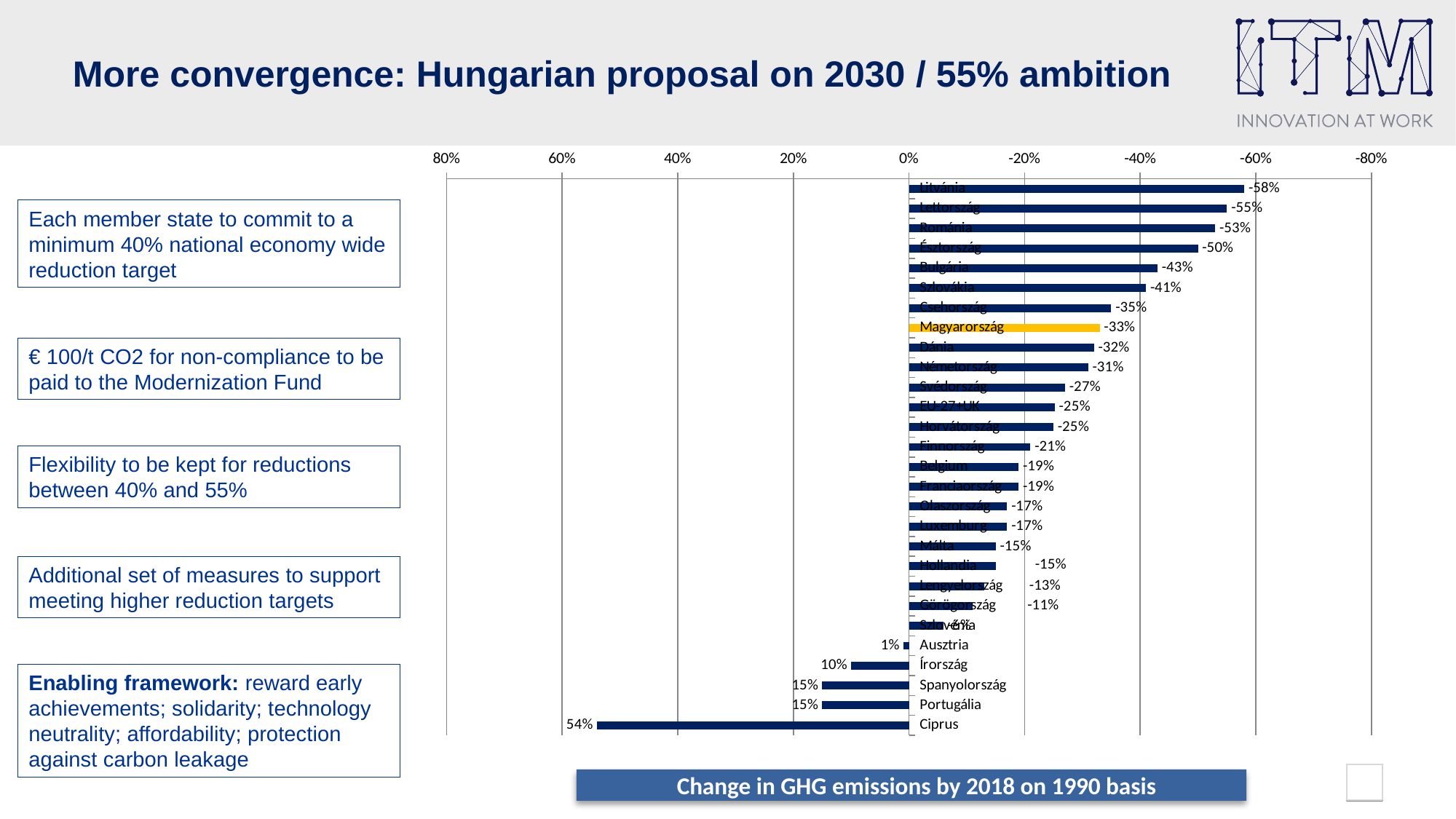
What type of chart is shown on the slide? Bar chart What is the value shown for Litvánia in the chart? -58% What is the value shown for Magyarország in the chart? -33% What is the value shown for EU-27+UK in the chart? -25% What is the value shown for Bulgária in the chart? -43% What is the value shown for Ciprus in the chart? 54% What is the difference in percentage points between the values for Litvánia and Lettország? 3 percentage points Which country's bar is highlighted in a different colour (yellow) in the chart? Magyarország Which country shows the largest increase in GHG emissions in the chart? Ciprus Is the value for Ciprus greater or less than 40%? greater Which has a larger reduction in GHG emissions, Románia or Észtország? Románia Which country shows the largest reduction in GHG emissions in the chart? Litvánia